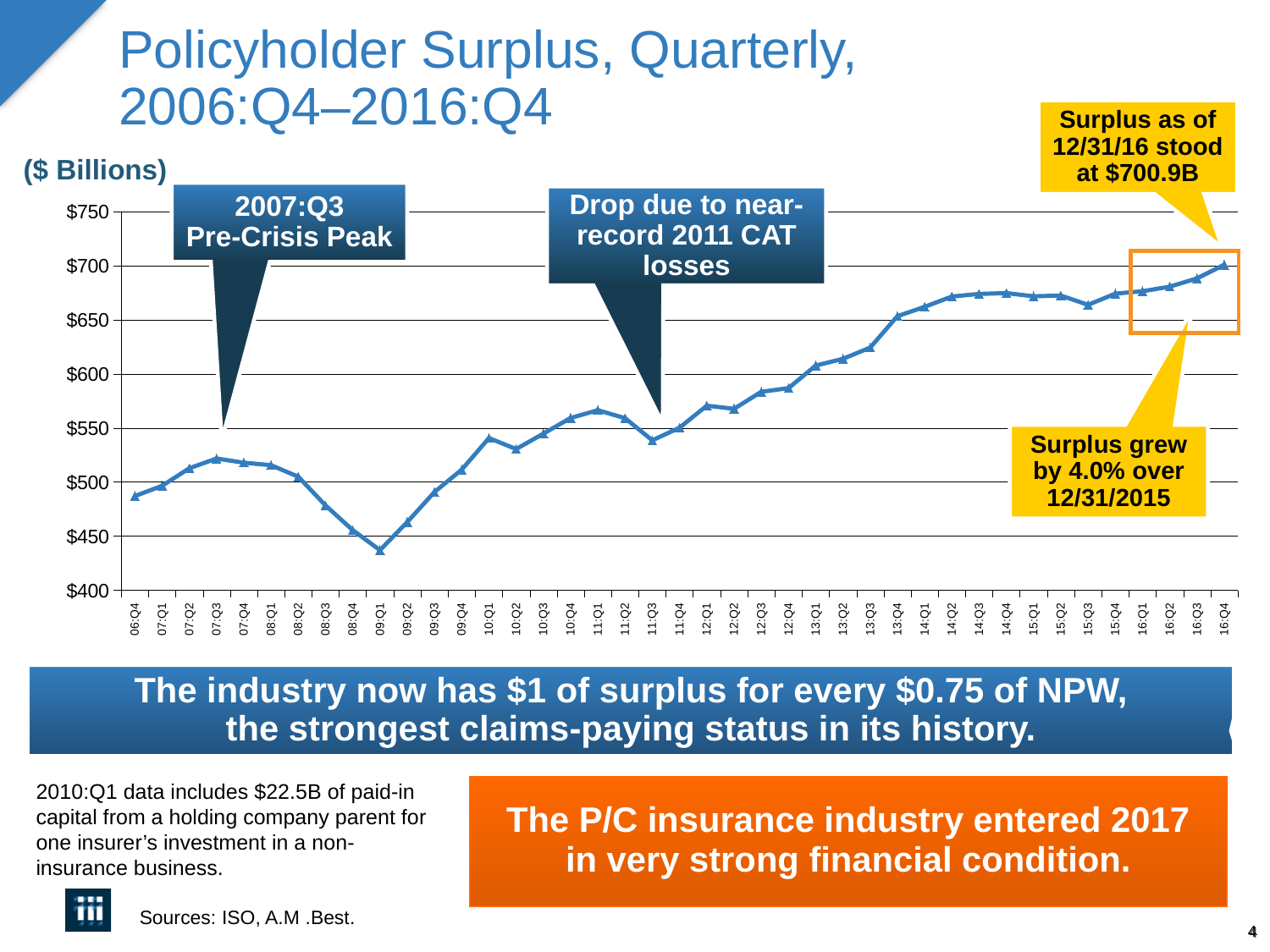
By what percentage did surplus grow over 12/31/2015, according to the callout? 4.0% How many quarterly data points are plotted on the chart? 41 What was the policyholder surplus as of 12/31/16 (2016:Q4) according to the callout? $700.9B Is the value for 07:Q3 greater or less than $500? greater Is the value for 09:Q1 greater or less than $450? less What kind of chart is shown on the slide? Line chart Which quarter has the highest policyholder surplus on the chart? 16:Q4 Which is larger, the surplus in 07:Q3 or in 09:Q1? 07:Q3 Which quarter has the lowest policyholder surplus on the chart? 09:Q1 Does the surplus rise or fall between 07:Q3 and 09:Q1? Fall Which quarter is labeled as the 'Pre-Crisis Peak' on the chart? 2007:Q3 Is the value for 14:Q1 greater or less than $650? greater